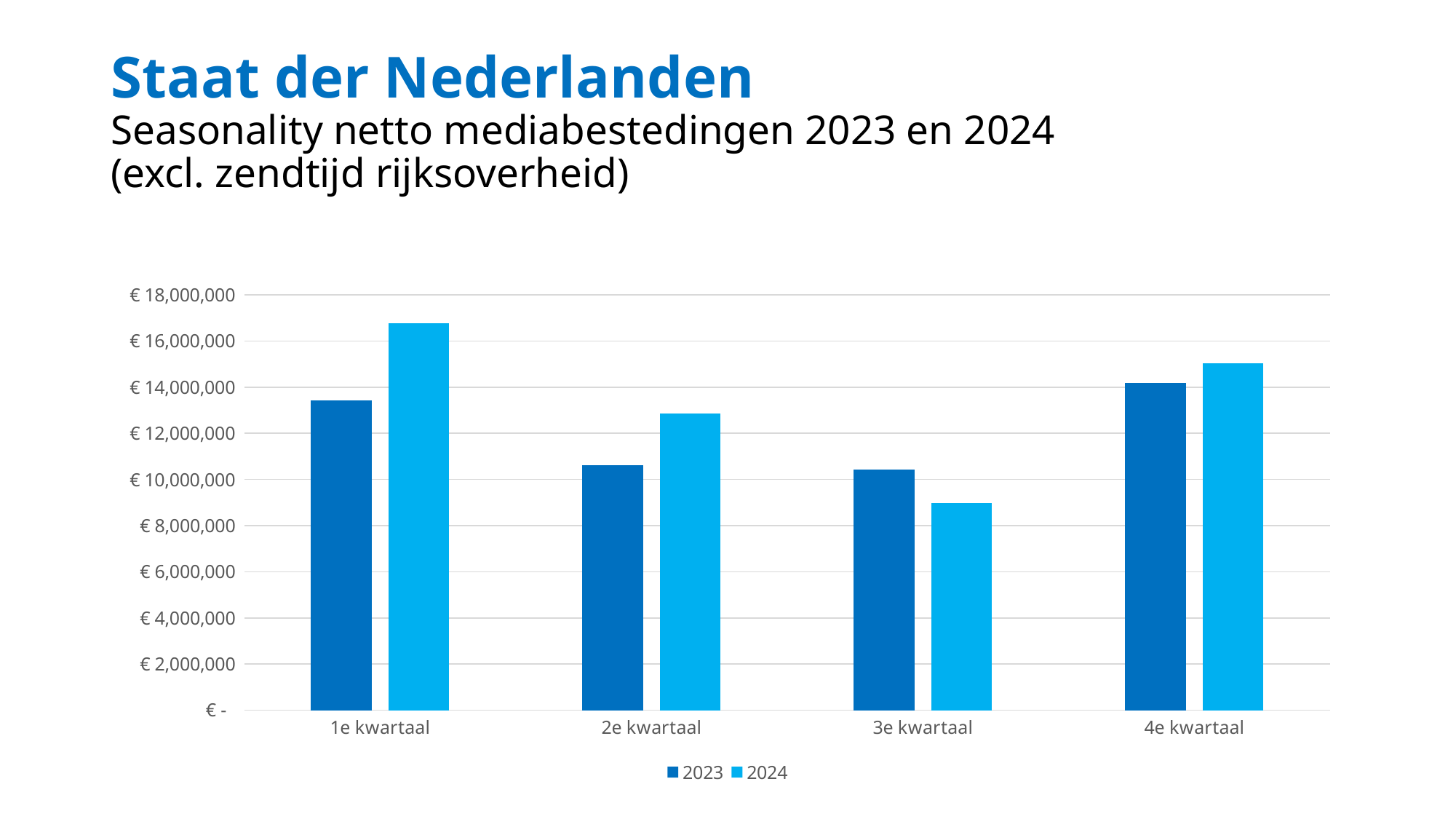
Which quarter has the lowest value for 2024? 3e kwartaal In 3e kwartaal, which year has the larger value, 2023 or 2024? 2023 What kind of chart is shown on the slide? bar chart How many quarters (categories) are shown on the x axis? 4 Which series is shown in the darker blue colour? 2023 Is the value for 2024 in 3e kwartaal greater or less than € 10,000,000? less Which quarter has the highest value for 2024? 1e kwartaal Which quarter has the highest value for 2023? 4e kwartaal Is the value for 2024 in 1e kwartaal greater or less than € 16,000,000? greater Is the value for 2023 in 1e kwartaal greater or less than € 14,000,000? less In 1e kwartaal, which year has the larger value, 2023 or 2024? 2024 How many series does the legend list? 2